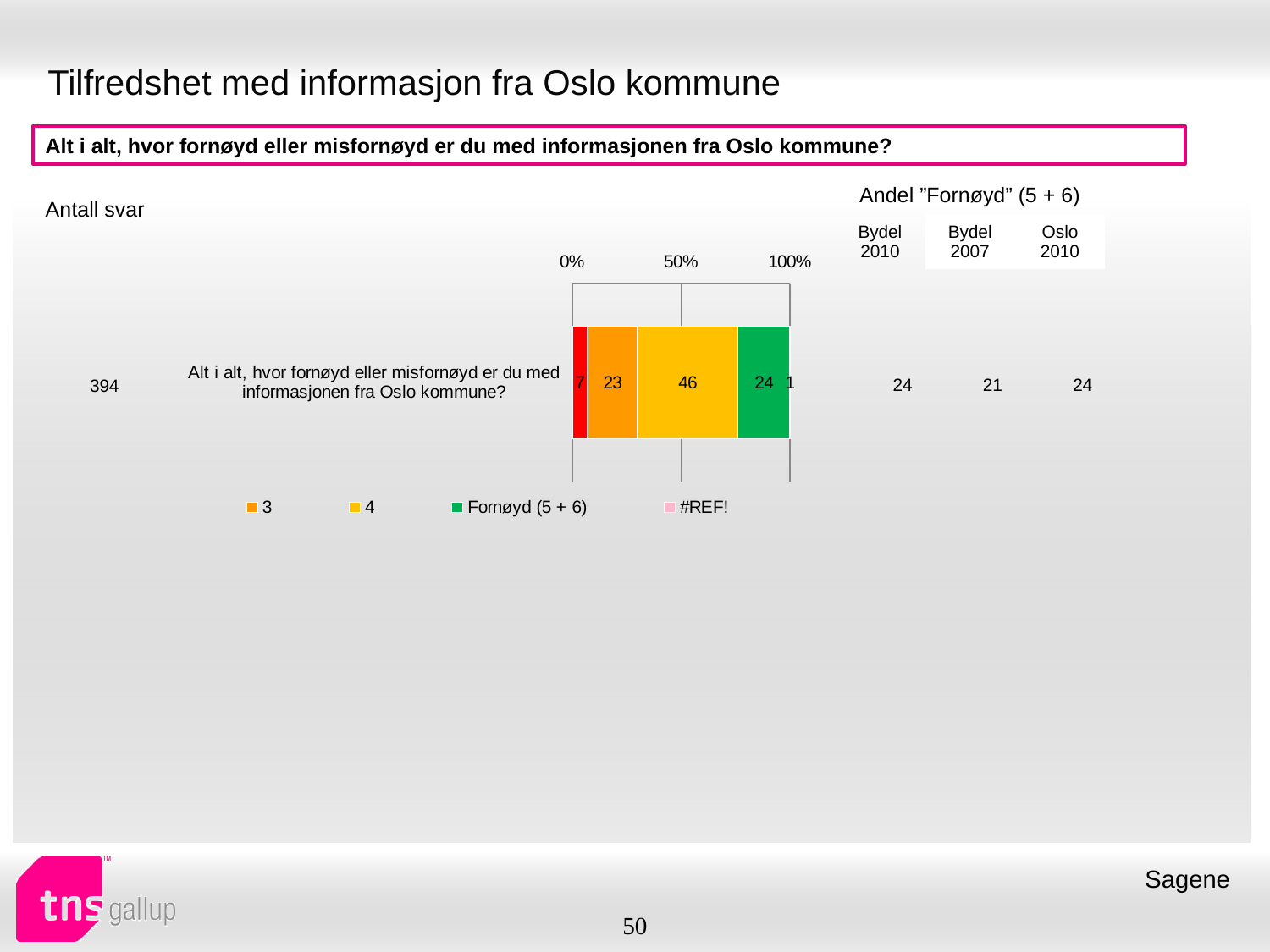
What is the difference between the "4" segment and the "3" segment? 23 What is the value of the "Fornøyd (5 + 6)" segment in the stacked bar? 24 What is the value of the "3" segment in the stacked bar? 23 Which segment is larger, "4" or "Fornøyd (5 + 6)"? 4 What is the value of the "4" segment in the stacked bar? 46 What colour is the "Fornøyd (5 + 6)" segment of the bar? green How many entries does the chart legend list? 4 How many bars does the chart contain? 1 Which legend category has the largest segment in the stacked bar? 4 What is the number of responses (Antall svar) shown for the question? 394 What kind of chart is shown on the slide? bar chart In the "Andel Fornøyd (5 + 6)" table, what is the value for Bydel 2007? 21